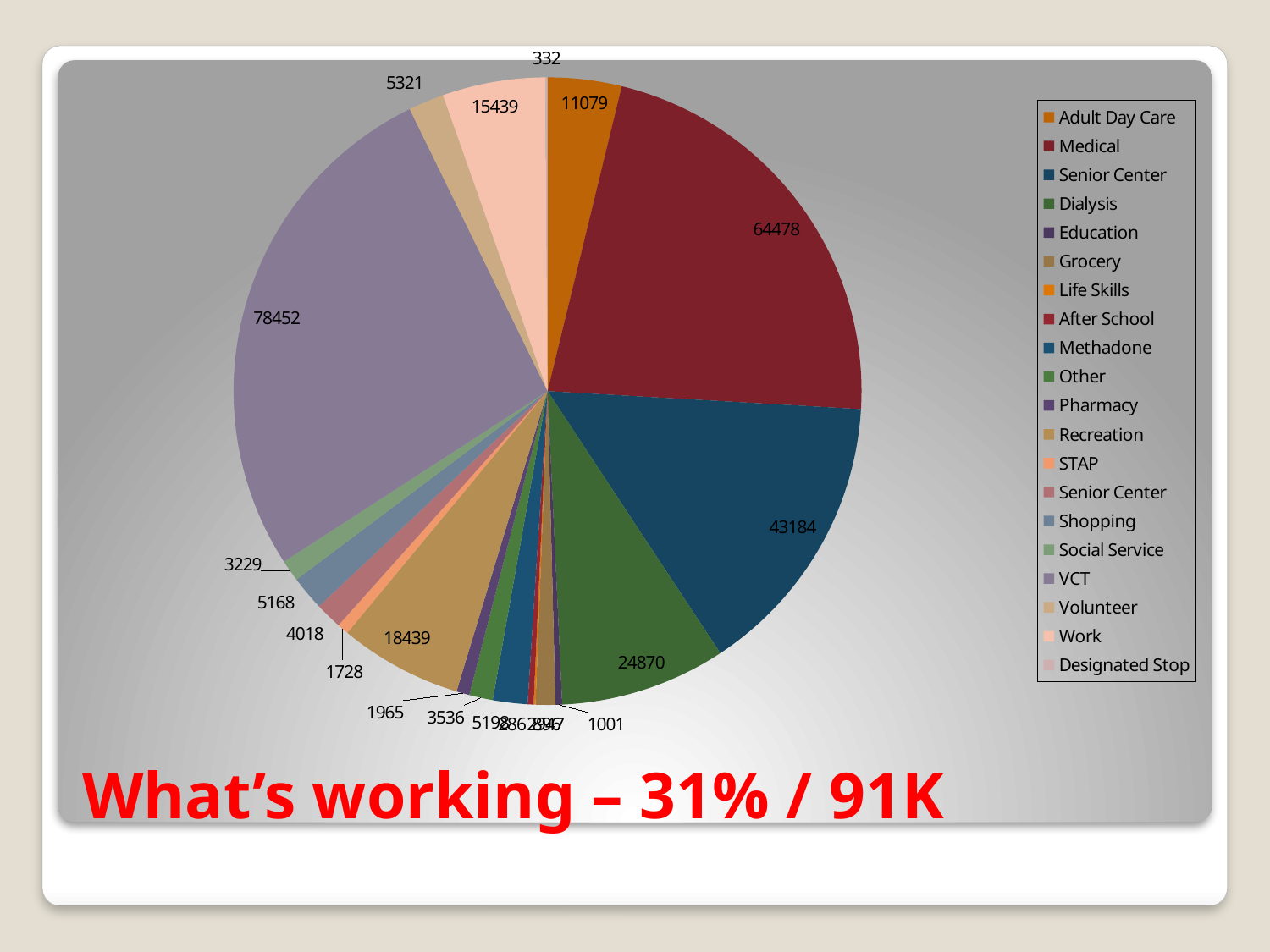
How many categories does the legend list? 20 Which category has the largest slice of the pie? VCT What is the title text shown below the chart? What's working – 31% / 91K Which is larger, the Dialysis slice or the Work slice? Dialysis What is the value for the Medical slice? 64478 What is the value for the Adult Day Care slice? 11079 What kind of chart is shown on the slide? pie chart What is the value for the Work slice? 15439 What is the difference between the Medical value and the Senior Center value of 43184? 21294 What is the value for the Dialysis slice? 24870 What is the value for the VCT slice? 78452